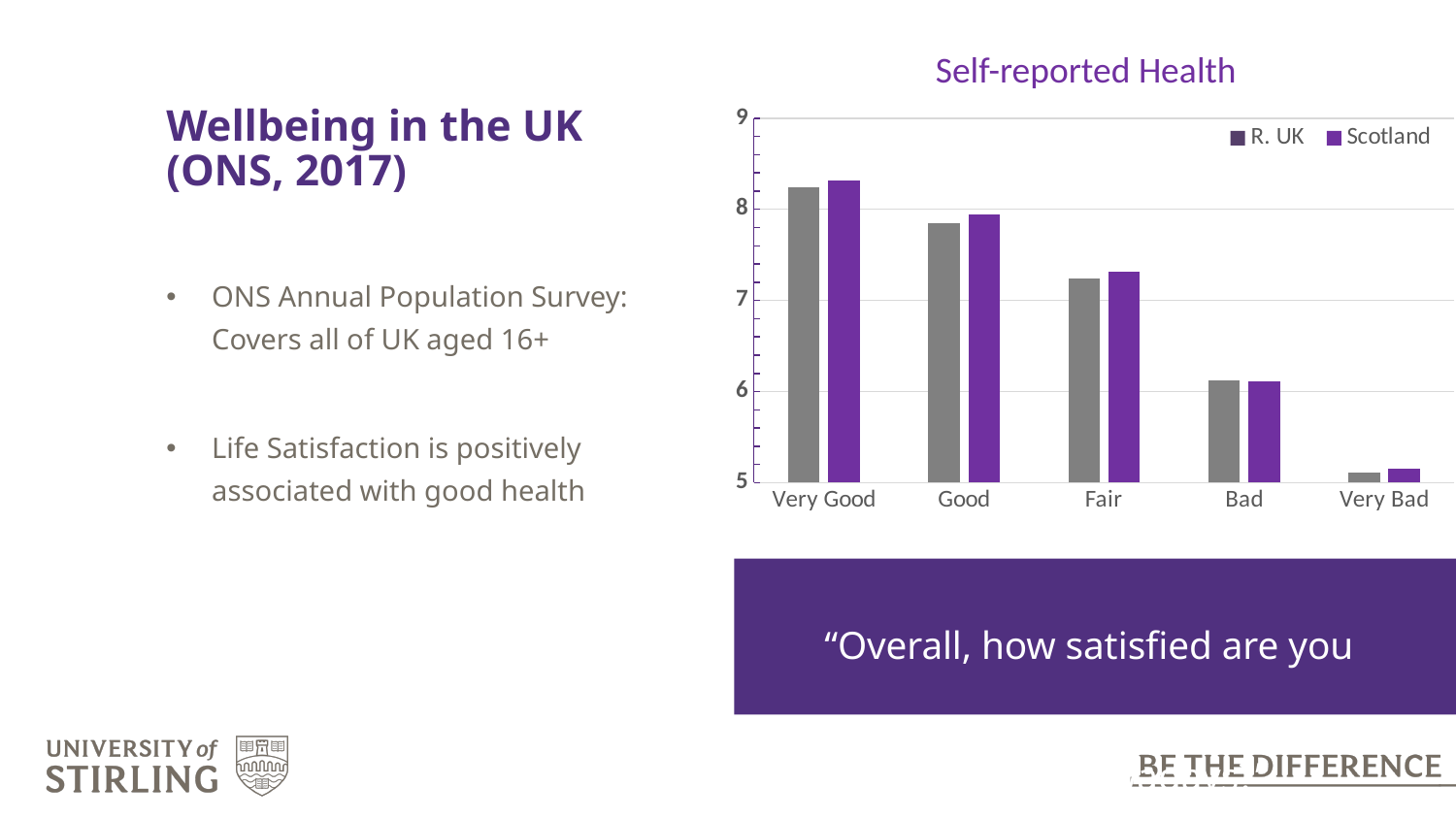
Is the Scotland value for Good greater or less than 8? less Which health category has the highest value for Scotland? Very Good How many self-reported health categories are shown on the x axis? 5 Do the values rise or fall moving from Very Good to Very Bad along the x axis? fall What is the title of the chart? Self-reported Health Is the R. UK value for Very Bad greater or less than 6? less Which two series are listed in the chart's legend? R. UK and Scotland Is the R. UK value for Fair greater or less than 7? greater Which health category has the lowest value for R. UK? Very Bad How many series does the chart's legend list? 2 What kind of chart is shown on the slide? bar chart